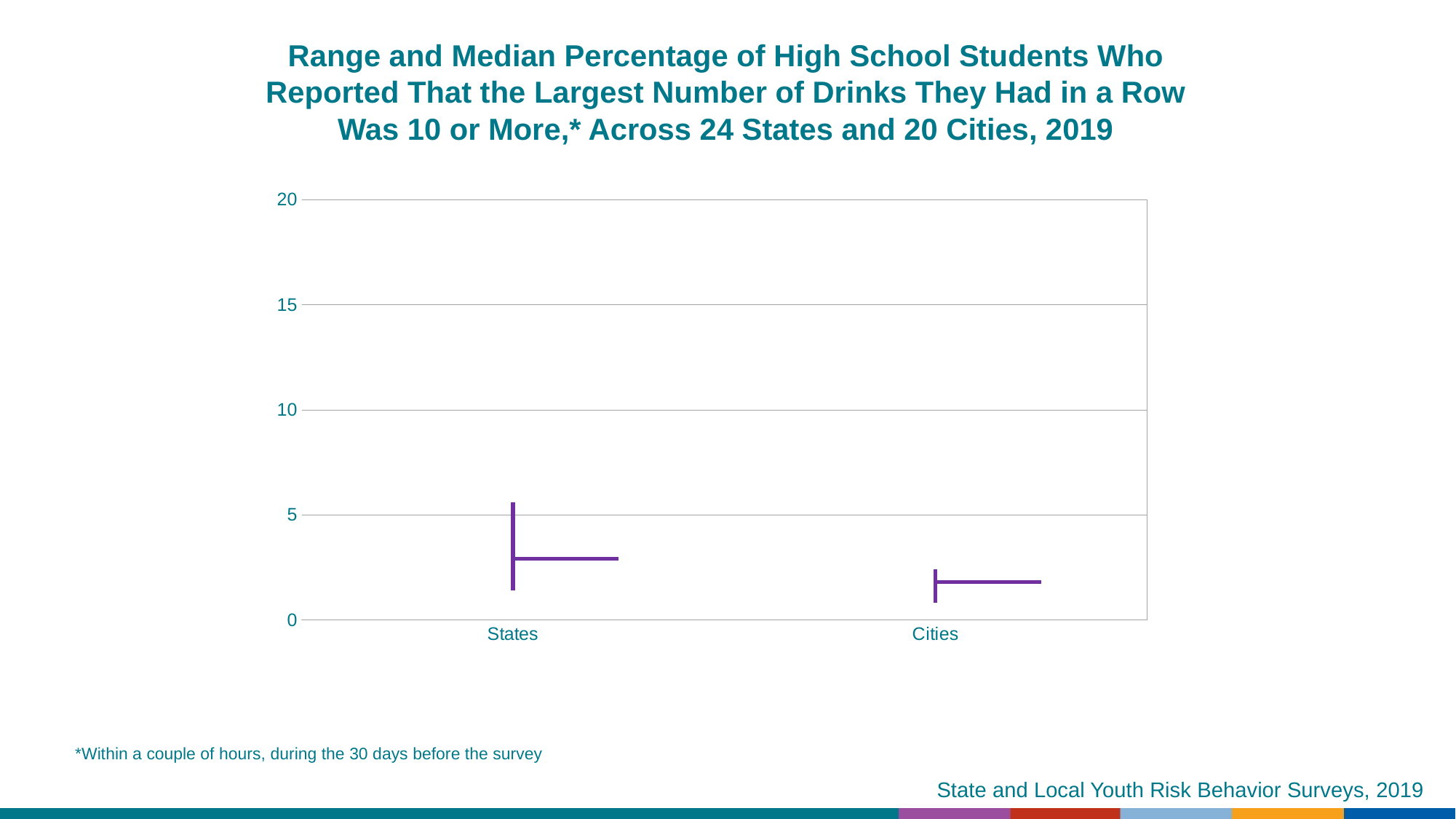
Is the top of the range for Cities greater or less than 5? less Is the top of the range for States greater or less than 10? less Which category has the higher top of its range, States or Cities? States Which category has the wider range, States or Cities? States Is the median value for Cities greater or less than 5? less What is the highest value shown on the y axis? 20 What are the two categories shown on the x axis? States and Cities How many categories are shown on the x axis of the chart? 2 According to the title, how many states and how many cities are included in the chart? 24 states and 20 cities Which category has the higher median percentage, States or Cities? States